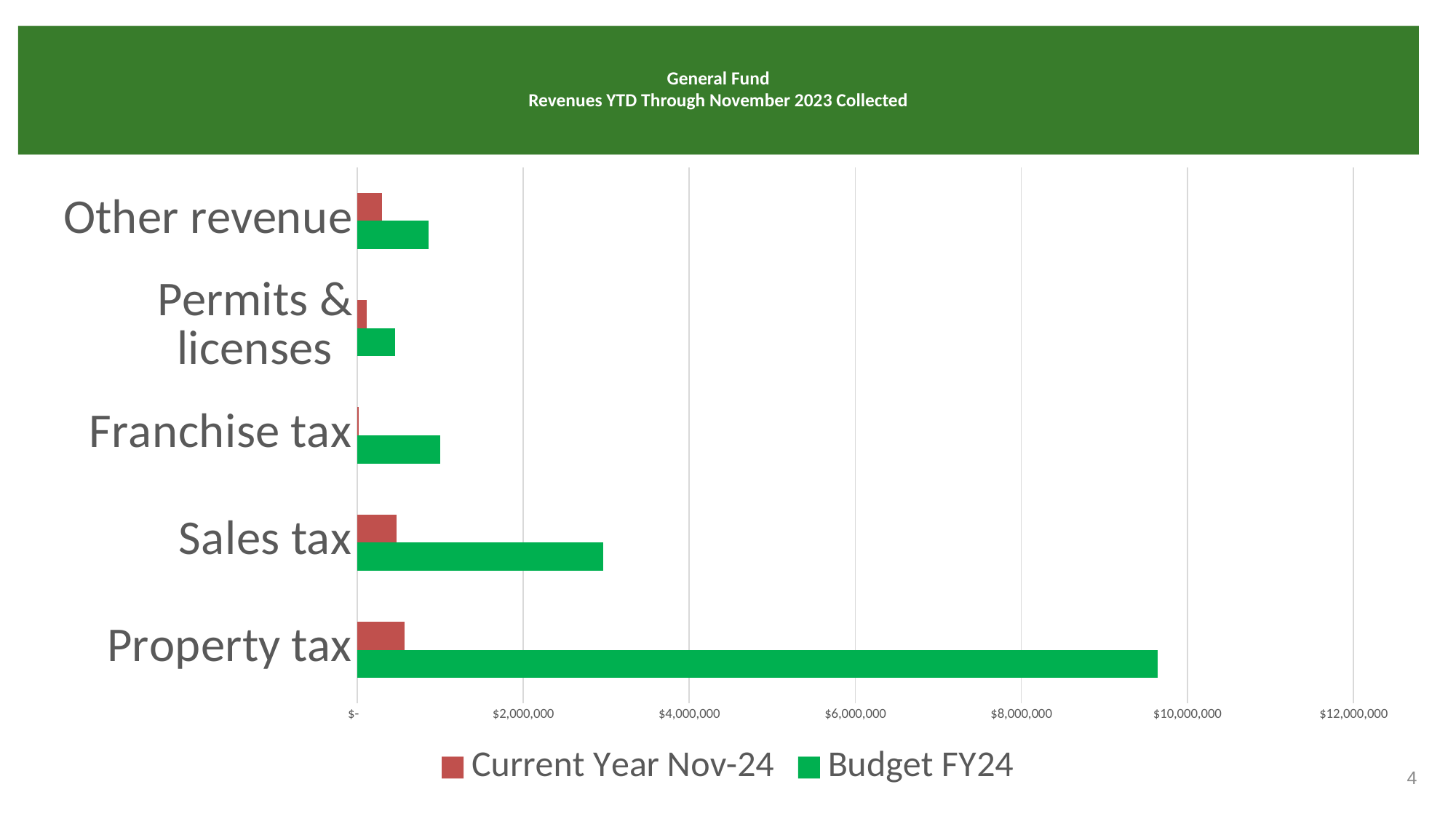
Is the Budget FY24 value for Franchise tax greater or less than $2,000,000? less Is the Budget FY24 value for Property tax greater or less than $8,000,000? greater Is the Budget FY24 value for Sales tax greater or less than $2,000,000? greater How many revenue categories are shown on the chart? 5 Which colour represents the Budget FY24 series? green Which category has the highest Budget FY24 value? Property tax How many series does the legend list? 2 Which is larger, the Budget FY24 value for Sales tax or for Other revenue? Sales tax What kind of chart is shown on the slide? bar chart Which category has the lowest Budget FY24 value? Permits & licenses Which category has the lowest Current Year Nov-24 value? Franchise tax